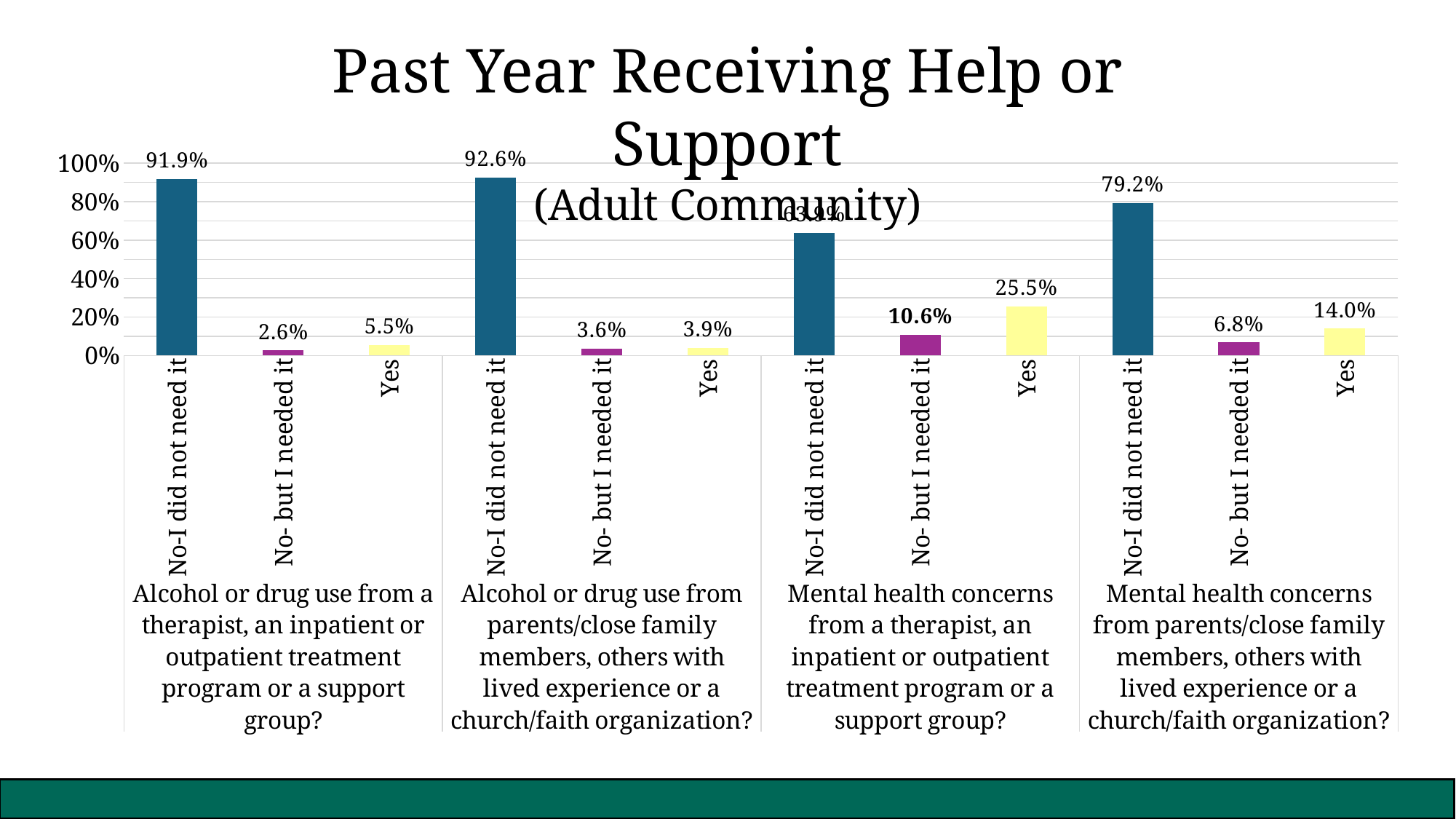
Which is larger: the "No- but I needed it" percentage for mental health concerns from a therapist or for mental health concerns from parents/close family members? Mental health concerns from a therapist, an inpatient or outpatient treatment program or a support group? Is the "No-I did not need it" value for mental health concerns from a therapist, an inpatient or outpatient treatment program or a support group greater or less than 80%? less What kind of chart is shown on the slide? Bar chart What percentage answered "No- but I needed it" for alcohol or drug use from a therapist, an inpatient or outpatient treatment program or a support group? 2.6% What percentage answered "No-I did not need it" for mental health concerns from parents/close family members, others with lived experience or a church/faith organization? 79.2% Which question has the lowest "No- but I needed it" percentage? Alcohol or drug use from a therapist, an inpatient or outpatient treatment program or a support group? What percentage answered "Yes" for mental health concerns from a therapist, an inpatient or outpatient treatment program or a support group? 25.5% Which question has the highest "No-I did not need it" percentage? Alcohol or drug use from parents/close family members, others with lived experience or a church/faith organization? What percentage answered "Yes" for alcohol or drug use from parents/close family members, others with lived experience or a church/faith organization? 3.9% How many bars are plotted in the chart in total? 12 What is the title of the chart? Past Year Receiving Help or Support (Adult Community) What is the difference between the "Yes" percentages for mental health concerns from a therapist (25.5%) and mental health concerns from parents/close family members (14.0%)? 11.5%